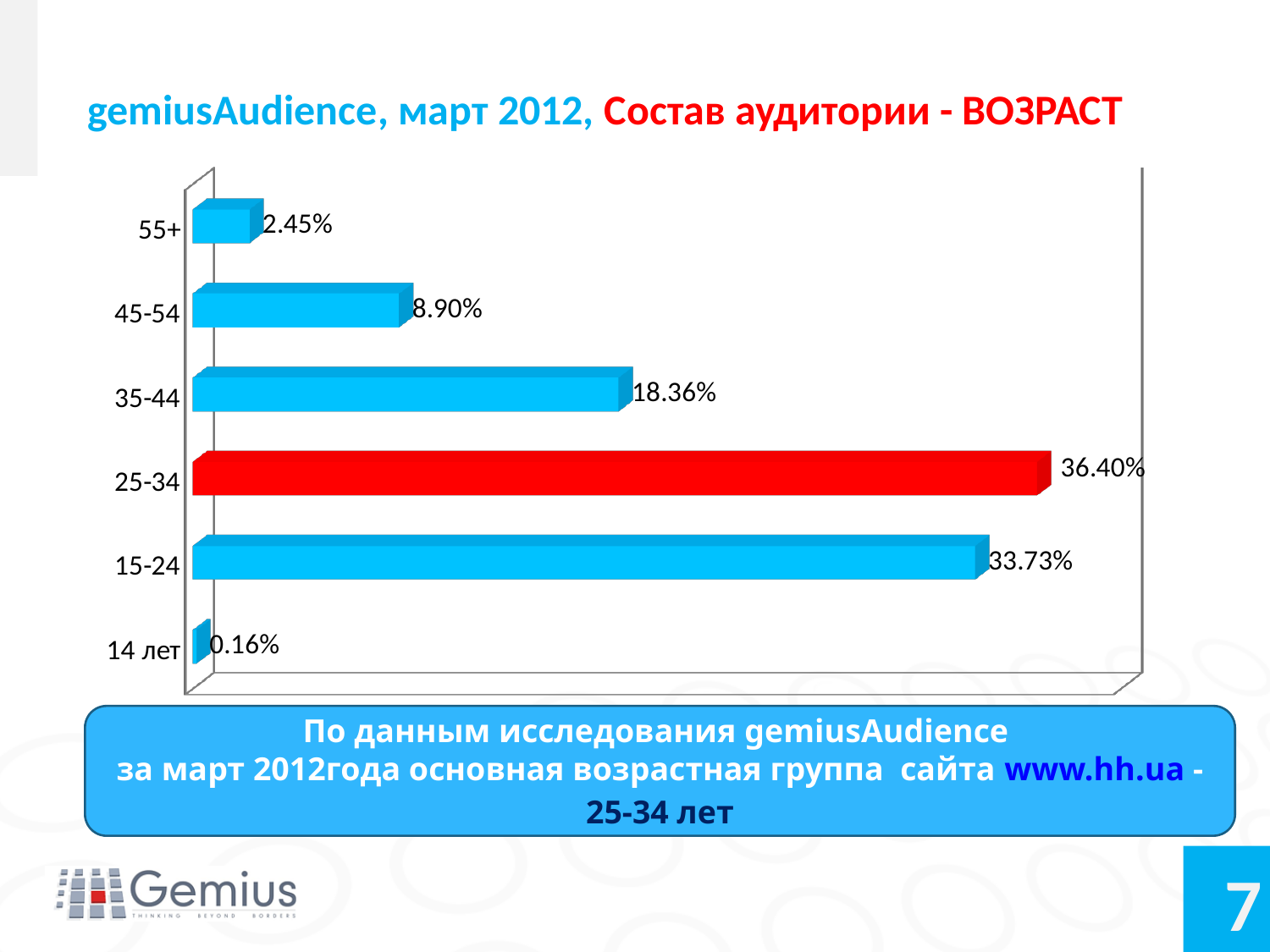
What kind of chart is shown on the slide? bar chart Which age group has the lowest value? 14 лет What is the value for the 14 лет category? 0.16% Which is larger, the value for 35-44 or the value for 45-54? 35-44 What is the value for the 55+ age group? 2.45% Which bar is coloured red instead of blue? 25-34 What is the difference between the values for 25-34 and 15-24? 2.67% What is the difference between the values for 35-44 and 45-54? 9.46% How many age categories are shown in the chart? 6 What is the value for the 25-34 age group? 36.40% Which age group has the highest value? 25-34 What is the value for the 45-54 age group? 8.90%